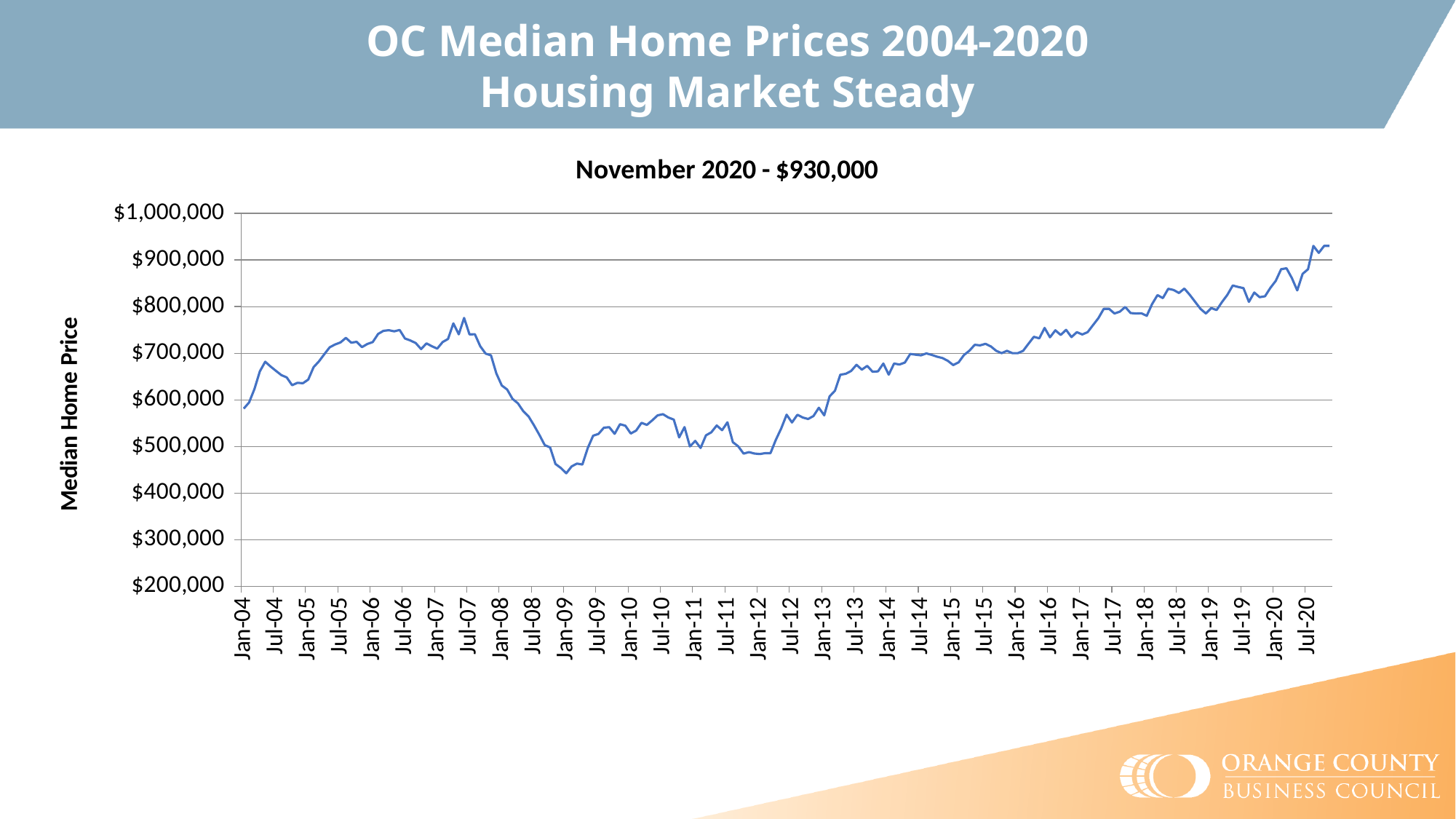
Is the median home price at Jul-20 greater or less than $800,000? greater What is the label on the vertical axis of the chart? Median Home Price Is the median home price at Jan-16 greater or less than $600,000? greater What kind of chart is shown on the slide? line chart Does the median home price rise or fall between Jul-07 and Jan-09? fall Which is higher, the median home price at Jan-09 or at Jan-16? Jan-16 Is the median home price at Jan-09 greater or less than $500,000? less Which is higher, the median home price at Jul-07 or at Jul-09? Jul-07 Does the median home price generally rise or fall between Jan-12 and Jul-20? rise What was the OC median home price in November 2020, as stated in the chart title? $930,000